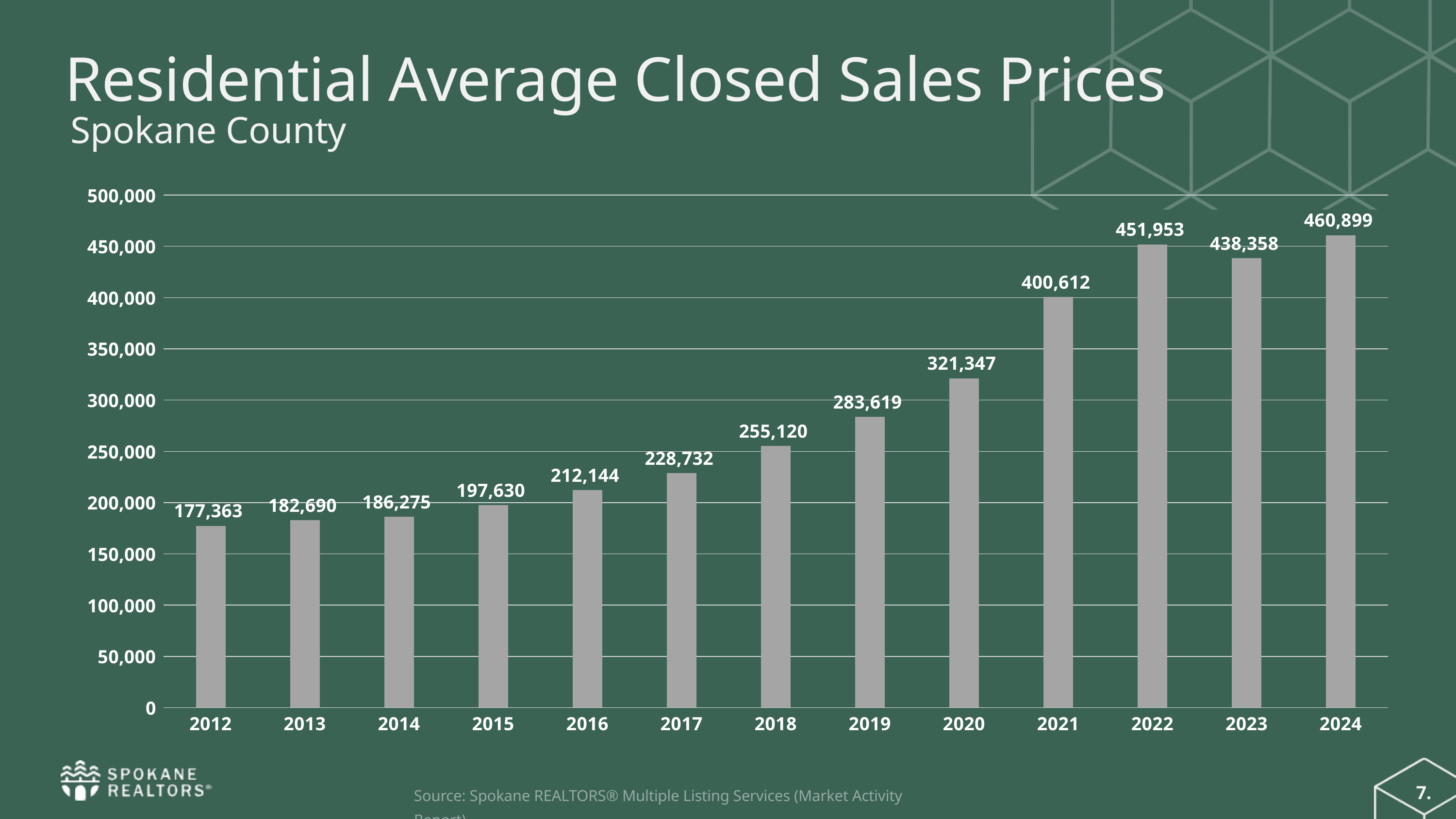
Which year has the highest average closed sales price? 2024 What is the difference between the average closed sales price in 2021 and in 2020? 79,265 Which year has the lowest average closed sales price? 2012 What is the residential average closed sales price for 2012? 177,363 What is the residential average closed sales price for 2020? 321,347 What is the residential average closed sales price for 2023? 438,358 How many years are shown on the x axis? 13 Do the average closed sales prices generally rise or fall from 2012 to 2024? rise Is the value for 2019 greater or less than 300,000? less What is the difference between the average closed sales price in 2024 and in 2023? 22,541 What kind of chart is shown on the slide? bar chart Which year has a higher average closed sales price, 2022 or 2023? 2022